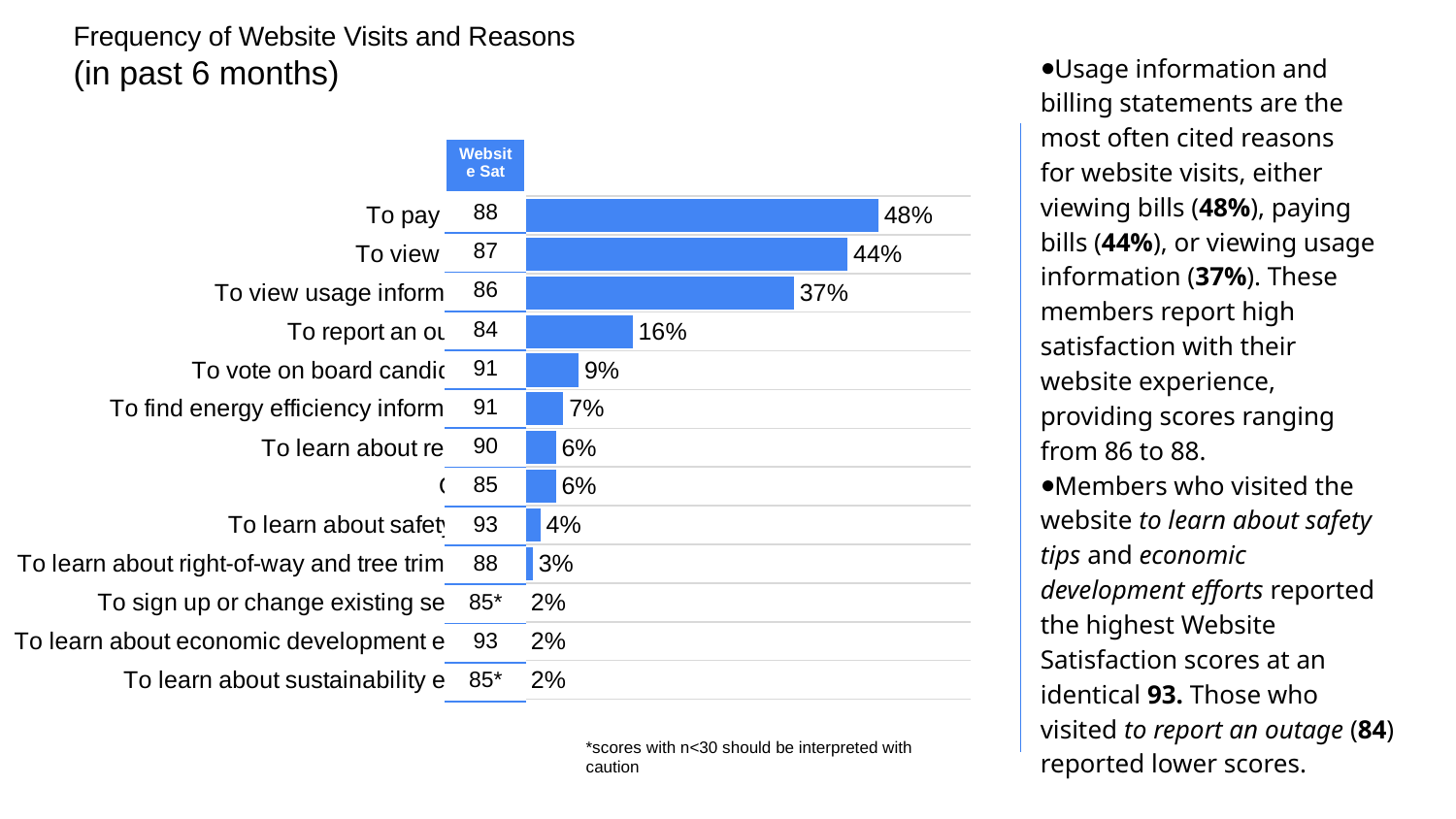
What is the difference in percentage between the 'To pay' bar and the 'To view' bar? 4% Which category has the highest percentage in the chart? To pay Which category has the lowest Website Sat score in the table next to the bars? To report an ou... What is the header of the score column shown to the left of the bars? Website Sat Which has a larger percentage: 'To vote on board candid...' or 'To find energy efficiency inform...'? To vote on board candid... What percentage is shown for the 'To report an ou...' category? 16% What is the Website Sat score for the 'To report an ou...' category? 84 What percentage is shown for the 'To view usage inform...' category? 37% What is the Website Sat score for the 'To learn about safety...' category? 93 How many categories (reasons for website visits) are plotted in the chart? 13 What percentage is shown for the 'To learn about right-of-way and tree trim...' category? 3% What kind of chart is shown on the slide? bar chart